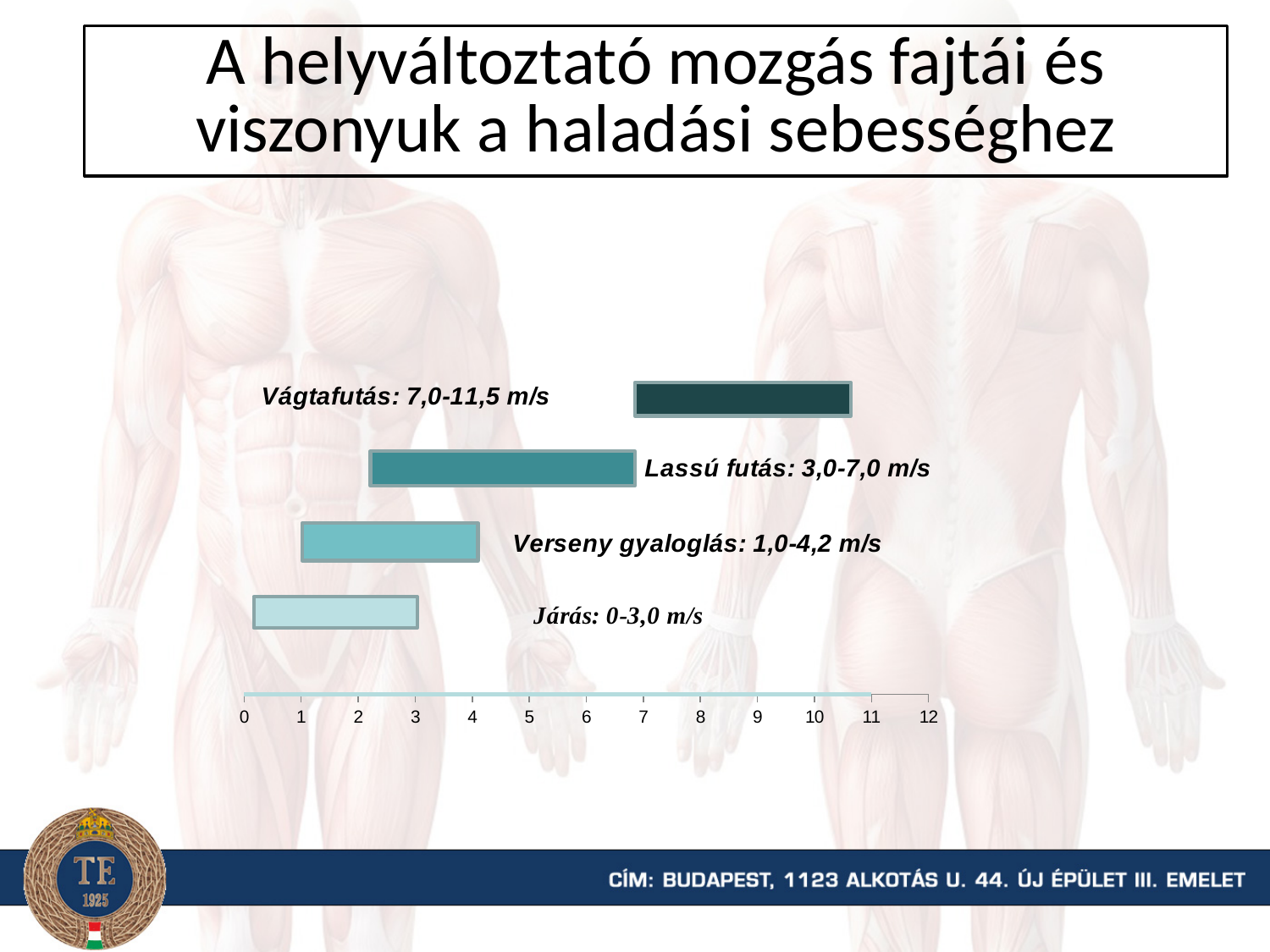
Which has a higher upper speed limit, Lassú futás or Verseny gyaloglás? Lassú futás Is the upper end of the Vágtafutás bar greater or less than 10? greater What speed range is shown for Vágtafutás? 7,0-11,5 m/s How many types of movement are plotted on the chart? 4 What is the highest value shown on the horizontal axis? 12 What kind of chart is shown on the slide? bar chart What speed range is shown for Lassú futás? 3,0-7,0 m/s What is the difference between the upper and lower speed limits of Vágtafutás? 4,5 m/s Which type of movement has the lowest starting speed on the chart? Járás What speed range is shown for Verseny gyaloglás? 1,0-4,2 m/s Which type of movement reaches the highest speed on the chart? Vágtafutás What speed range is shown for Járás? 0-3,0 m/s